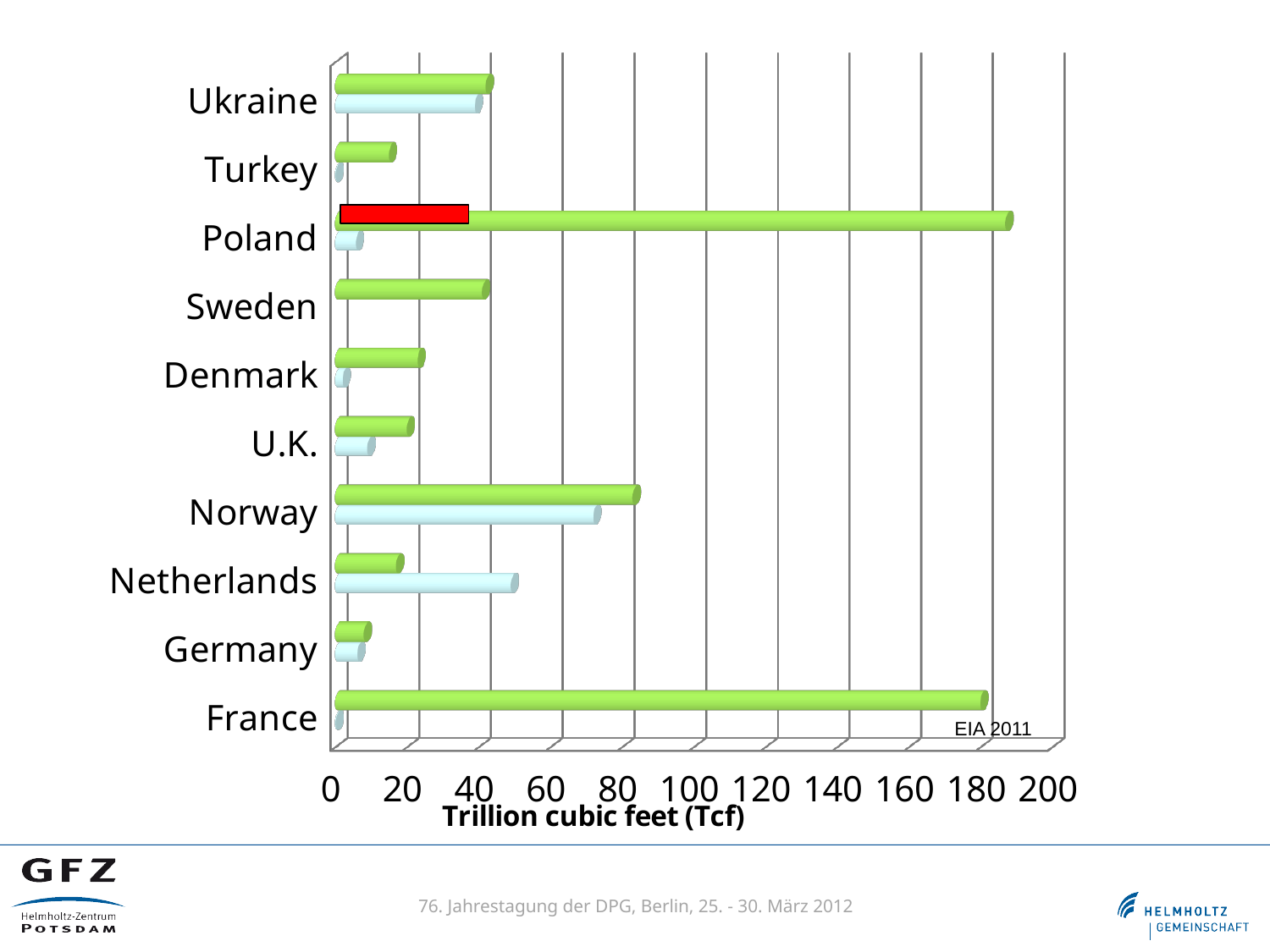
What is the title of the x axis? Trillion cubic feet (Tcf) For Netherlands, which bar is longer, the green bar or the light blue bar? light blue bar Is the green bar for Turkey greater or less than 20? less Which country has the longest light blue bar? Norway Which country has the shortest green bar? Germany Is the light blue bar for Netherlands greater or less than 40? greater Which is larger, the green bar for Norway or the green bar for Ukraine? Norway Is the green bar for France greater or less than 160? greater What source is cited in the bottom right corner of the chart? EIA 2011 How many countries are listed on the chart? 10 What kind of chart is shown on the slide? bar chart Which country has the longest green bar? Poland